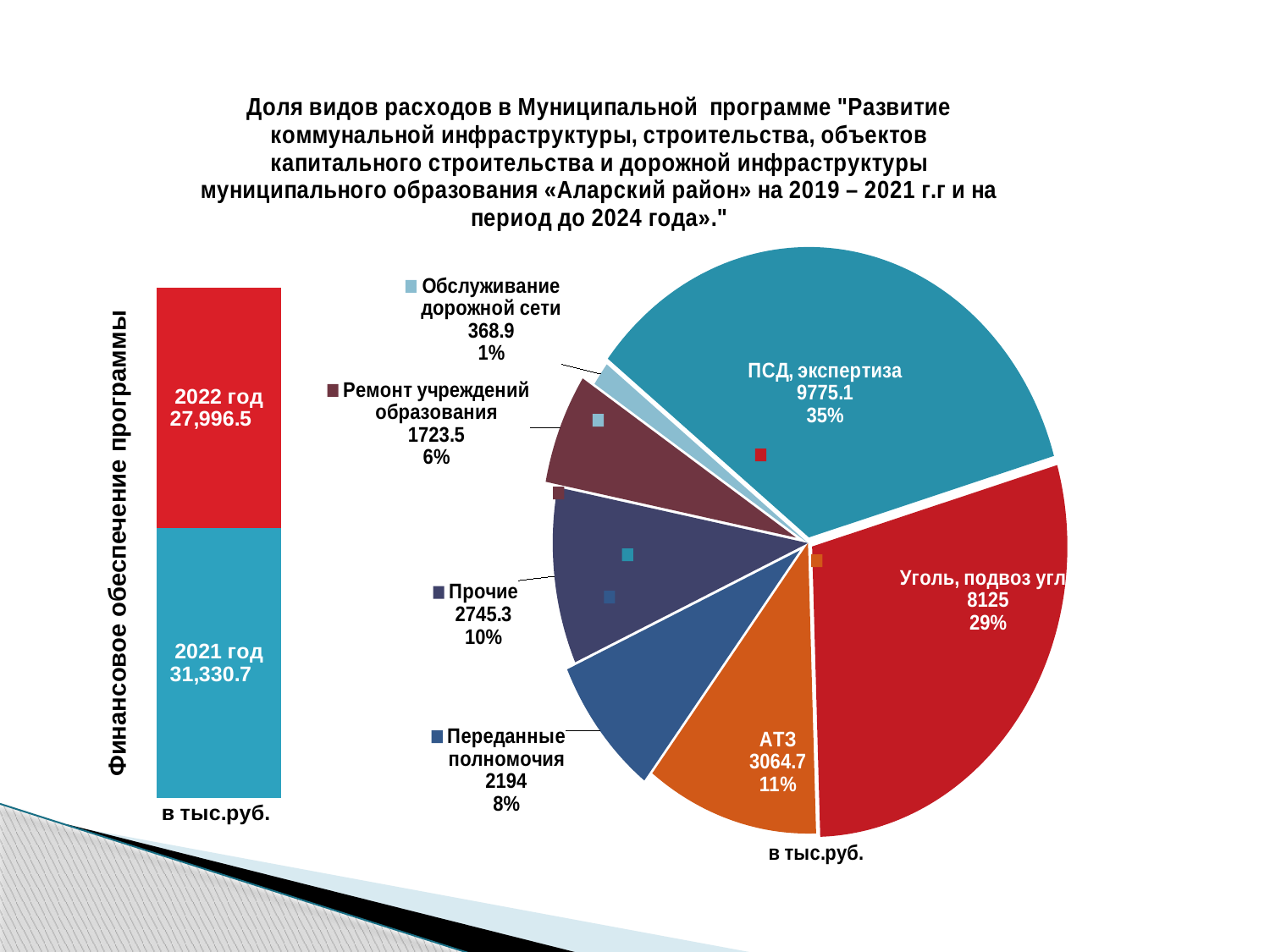
In the stacked bar chart on the left, what is the value for 2021 год? 31,330.7 In the pie chart, what share does the Уголь slice have? 29% In the pie chart, what is the difference between ПСД, экспертиза and the Уголь slice? 1650.1 In the pie chart, which category has the smallest slice? Обслуживание дорожной сети In the pie chart, which is larger: Прочие or Переданные полномочия? Прочие In the pie chart, how many slices are there? 7 In the pie chart, which category has the largest slice? ПСД, экспертиза In the pie chart, what is the value for АТЗ? 3064.7 In the stacked bar chart on the left, which year has the larger value, 2021 год or 2022 год? 2021 год What type of chart is shown on the left side of the slide? Bar chart In the stacked bar chart on the left, what is the total of the bar? 59,327.2 In the pie chart, what is the value for ПСД, экспертиза? 9775.1